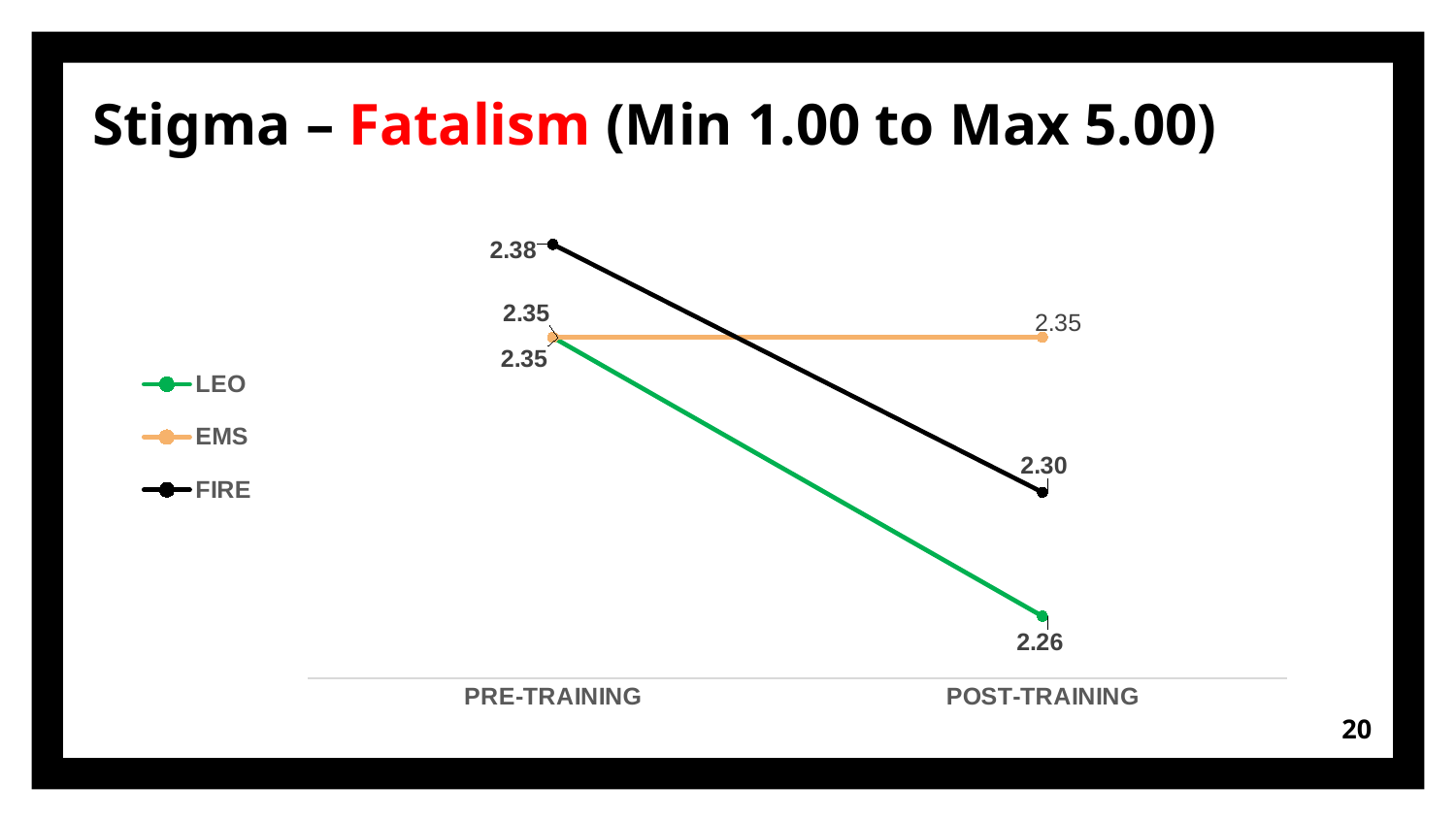
Which series has the highest value at pre-training? FIRE Which is larger at post-training, EMS or FIRE? EMS How many series does the legend list? 3 What is the FIRE value at pre-training? 2.38 What is the difference between the FIRE pre-training and post-training values? 0.08 How many categories are shown on the x axis? 2 What is the EMS value at post-training? 2.35 Does the LEO line rise or fall from pre-training to post-training? fall What kind of chart is shown on the slide? line chart What is the FIRE value at post-training? 2.30 Which series has the lowest value at post-training? LEO What is the LEO value at post-training? 2.26